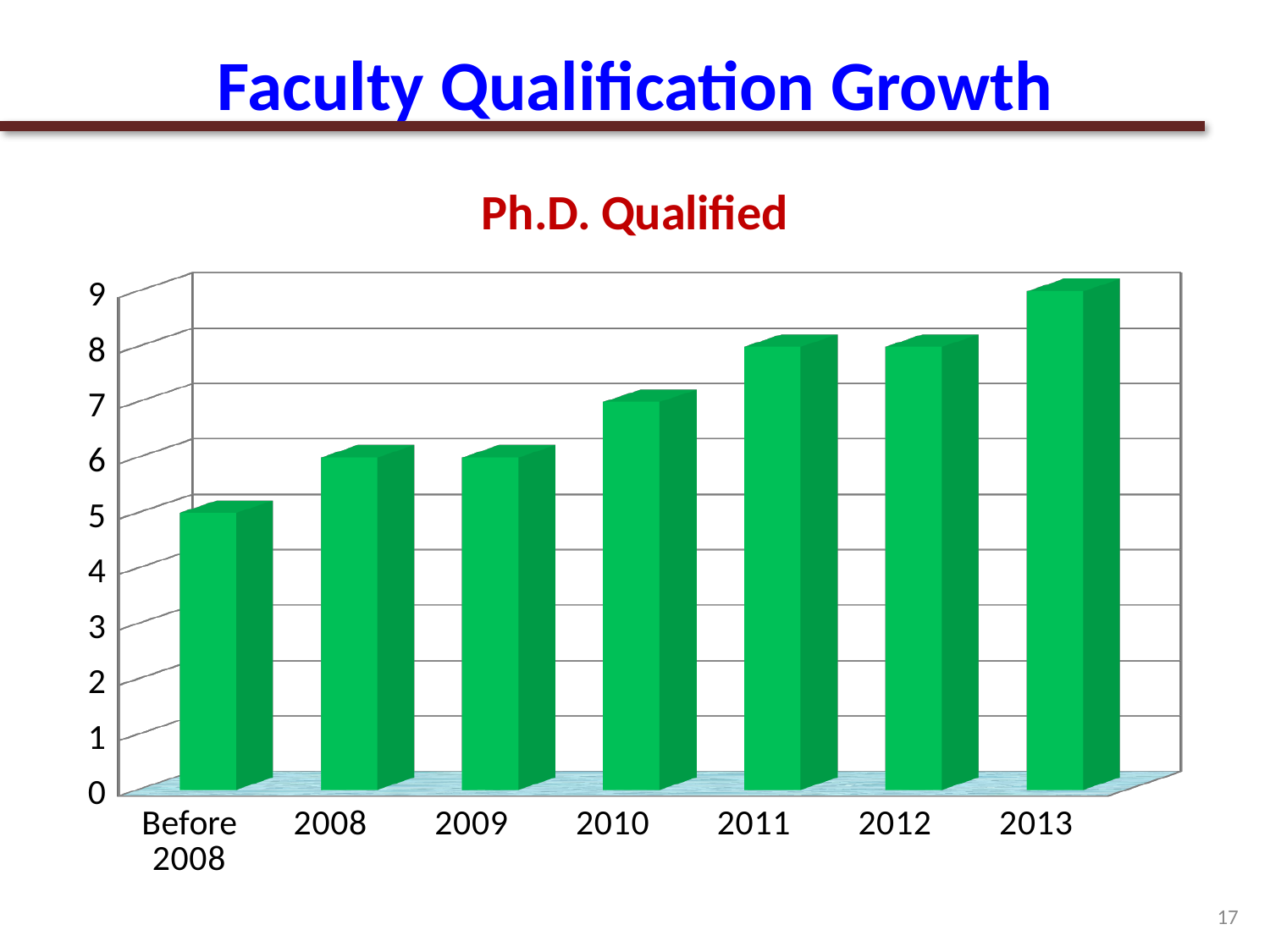
What is the value for 2013 in the chart? 9 How many categories are shown on the x axis of the chart? 7 Do the values generally rise or fall from Before 2008 to 2013? rise Is the value for 2009 greater or less than 7? less What is the value for 2010 in the chart? 7 What is the title of the chart? Ph.D. Qualified What kind of chart is shown on the slide? bar chart Which category has the lowest bar in the chart? Before 2008 Is the value for 2011 greater or less than 7? greater Which is larger, the value for 2010 or the value for 2013? 2013 What is the value for Before 2008 in the chart? 5 Which category has the highest bar in the chart? 2013